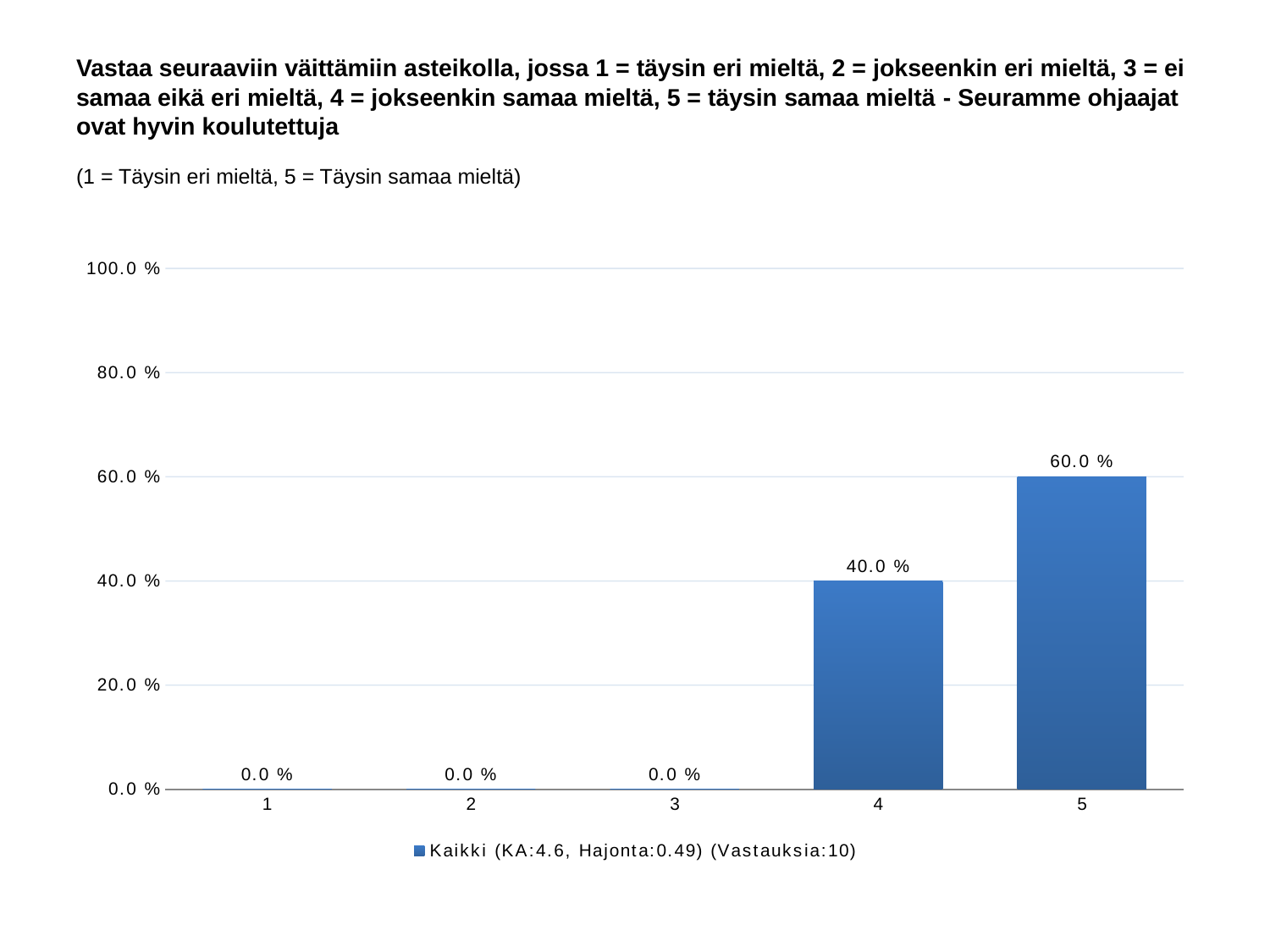
Which is larger, the value for category 4 or category 5? 5 What is the legend entry for the series? Kaikki (KA:4.6, Hajonta:0.49) (Vastauksia:10) Do the values rise or fall from category 3 to category 5? rise What kind of chart is shown? bar chart How many categories are shown on the x axis? 5 What is the difference between the values for category 5 and category 4? 20.0 % Is the value for category 5 greater or less than 80.0 %? less What is the value for category 1? 0.0 % What is the value for category 4? 40.0 % Which category has the highest value? 5 How many series does the legend list? 1 What is the value for category 5? 60.0 %